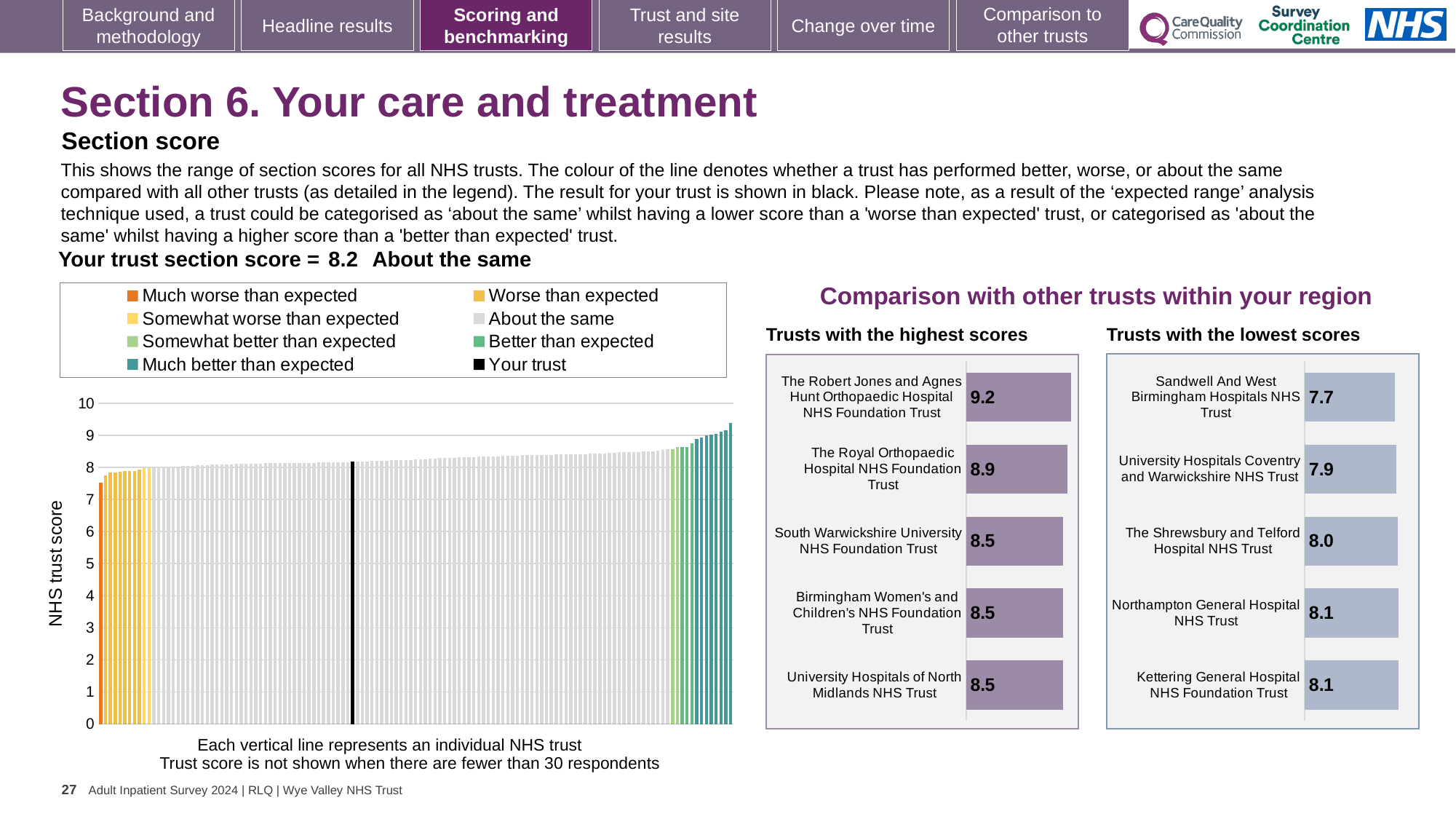
In the 'Trusts with the highest scores' chart, how many trusts are listed? 5 What kind of chart is the large chart on the left showing NHS trust scores? Bar chart How many entries does the legend of the large chart on the left list? 8 In the 'Trusts with the lowest scores' chart, which has the higher score: University Hospitals Coventry and Warwickshire NHS Trust or Northampton General Hospital NHS Trust? Northampton General Hospital NHS Trust What is the y-axis label of the large chart on the left? NHS trust score In the 'Trusts with the highest scores' chart, what is the difference between the scores of The Robert Jones and Agnes Hunt Orthopaedic Hospital NHS Foundation Trust and South Warwickshire University NHS Foundation Trust? 0.7 In the large chart on the left, do the bar values rise or fall from left to right? Rise In the 'Trusts with the highest scores' chart, what is the score for The Royal Orthopaedic Hospital NHS Foundation Trust? 8.9 In the 'Trusts with the highest scores' chart, what is the score for The Robert Jones and Agnes Hunt Orthopaedic Hospital NHS Foundation Trust? 9.2 In the 'Trusts with the lowest scores' chart, what is the difference between the scores of Kettering General Hospital NHS Foundation Trust and Sandwell And West Birmingham Hospitals NHS Trust? 0.4 In the 'Trusts with the lowest scores' chart, which trust has the lowest score? Sandwell And West Birmingham Hospitals NHS Trust In the 'Trusts with the lowest scores' chart, what is the score for The Shrewsbury and Telford Hospital NHS Trust? 8.0